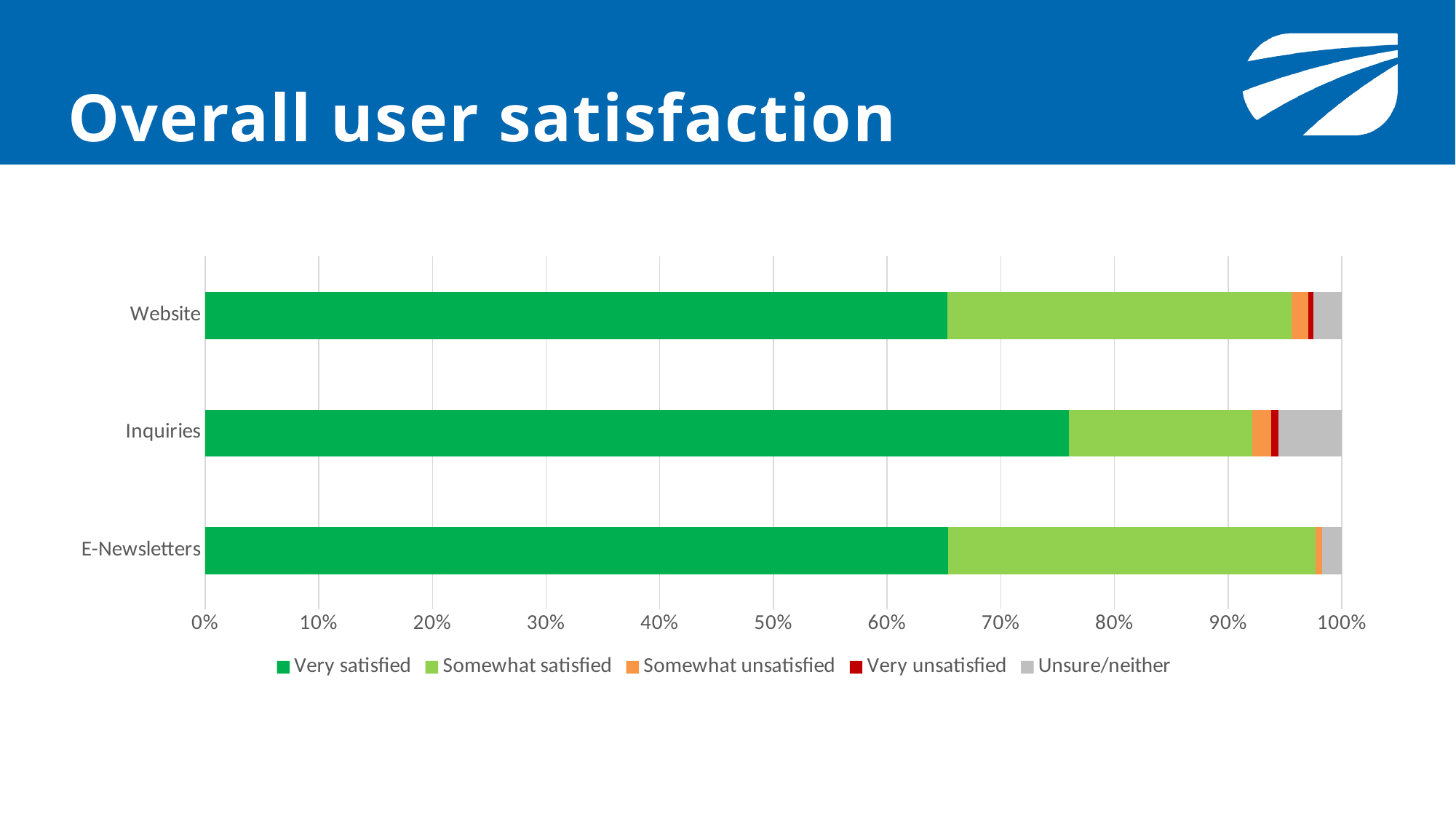
What is the title of the slide's chart? Overall user satisfaction Which category has the largest Unsure/neither segment? Inquiries How many categories are plotted on the chart? 3 Which is larger, the Very satisfied share for Inquiries or for Website? Inquiries What kind of chart is shown on the slide? bar chart Which category has the largest Very satisfied share? Inquiries Which category has the largest Somewhat satisfied segment? E-Newsletters How many series does the legend list? 5 Is the Very satisfied share for Website greater or less than 70%? less Is the Very satisfied share for Inquiries greater or less than 70%? greater Is the Very satisfied share for E-Newsletters greater or less than 60%? greater Which category has the smallest Somewhat satisfied segment? Inquiries